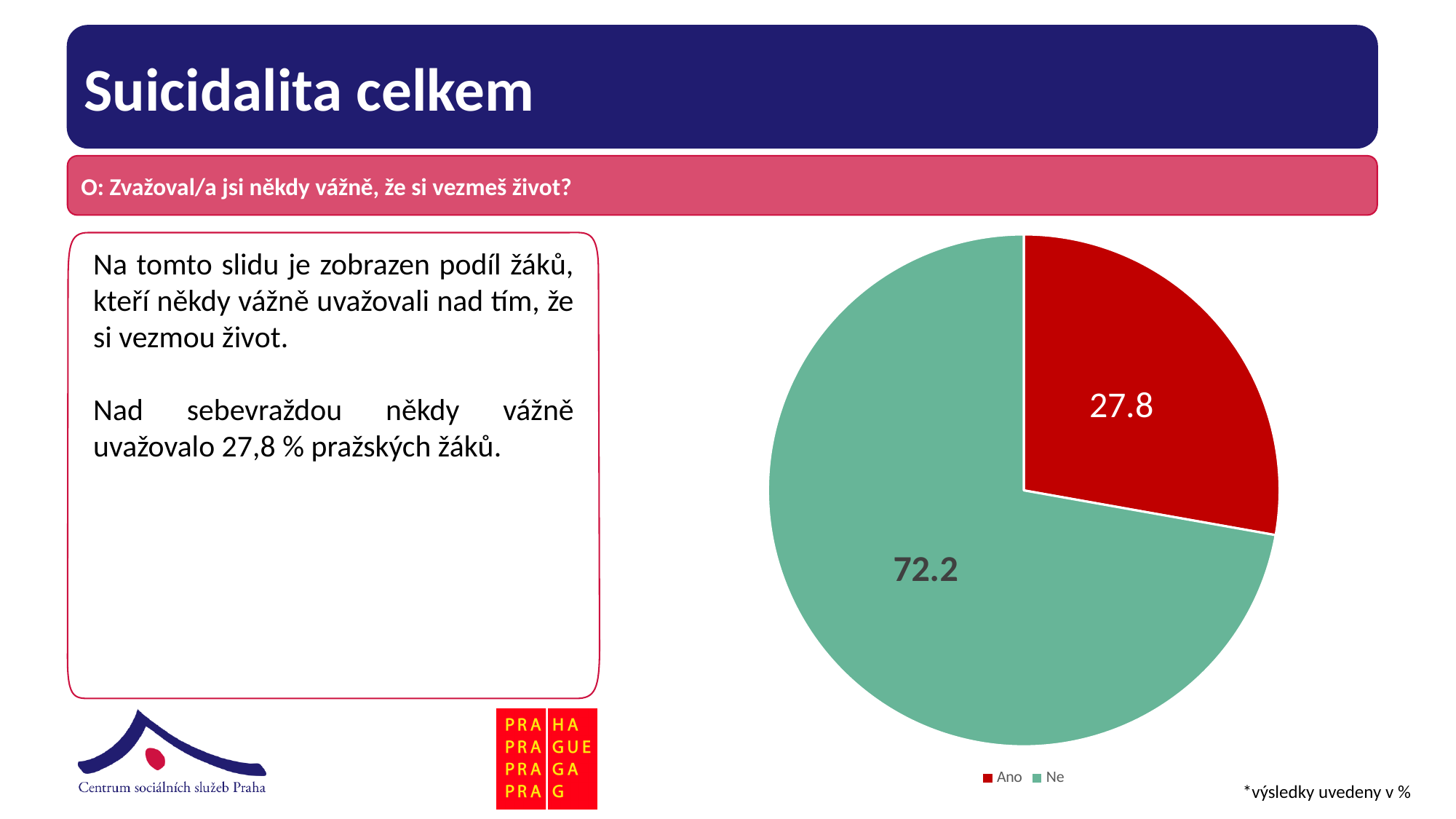
Which slice of the pie chart is the largest? Ne What is the difference between the values for "Ne" and "Ano"? 44.4 What kind of chart is shown on the slide? pie chart What is the value for "Ne" in the pie chart? 72.2 What colour is the "Ano" slice in the pie chart? red Which slice of the pie chart is the smallest? Ano Which is larger, the value for "Ano" or the value for "Ne"? Ne What share of the pie does the "Ano" slice represent? 27.8% How many entries does the legend of the pie chart list? 2 What is the value for "Ano" in the pie chart? 27.8 What colour is the "Ne" slice in the pie chart? green How many slices does the pie chart have? 2